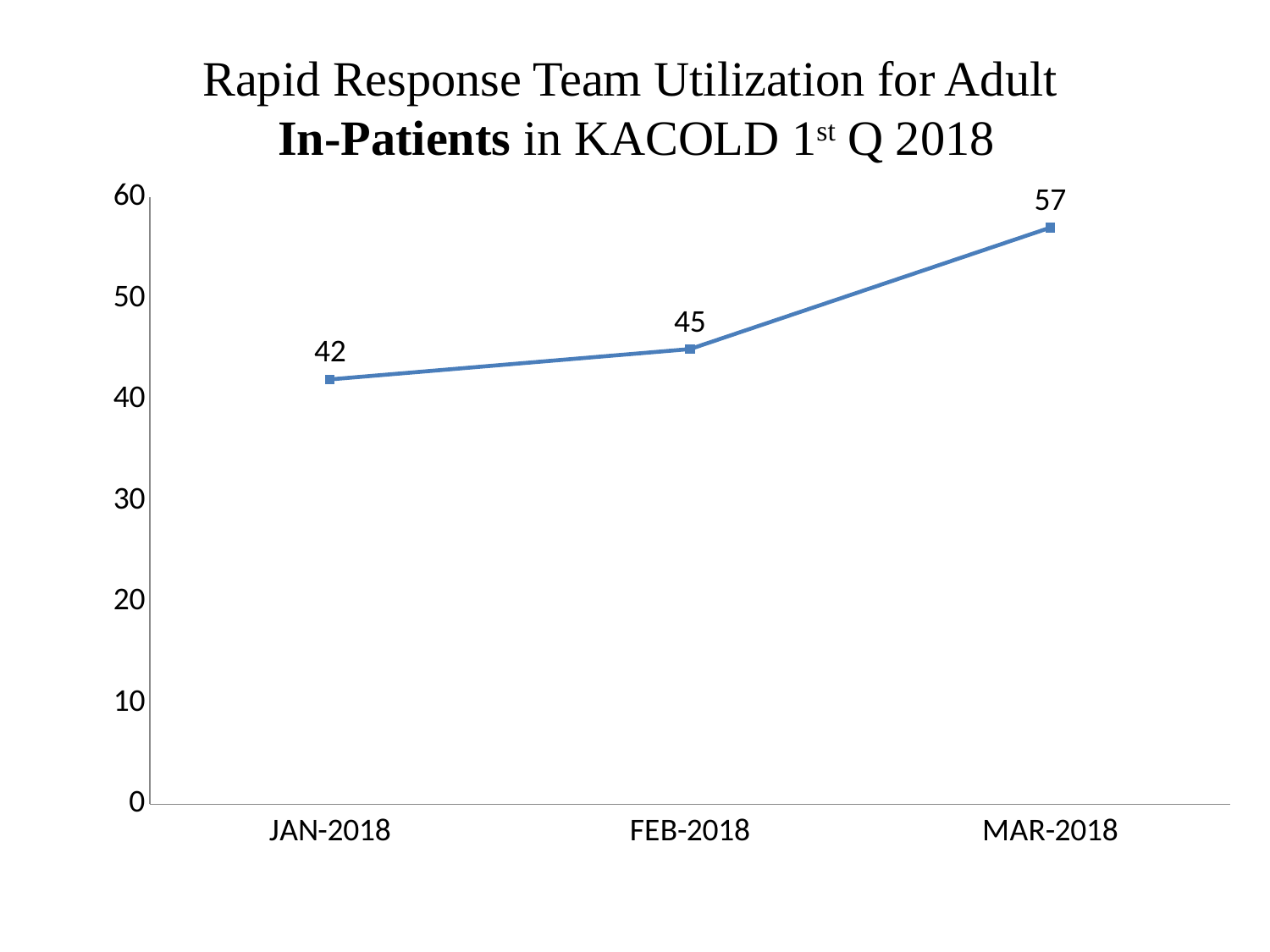
Is the value for MAR-2018 greater or less than 50? greater What is the difference between the values for MAR-2018 and JAN-2018? 15 What is the value for FEB-2018? 45 Do the values rise or fall from JAN-2018 to MAR-2018? rise Which is larger, the value for FEB-2018 or the value for MAR-2018? MAR-2018 What is the value for JAN-2018? 42 Which month has the highest value? MAR-2018 What is the value for MAR-2018? 57 How many months are plotted on the chart? 3 Which month has the lowest value? JAN-2018 What kind of chart is shown on the slide? line chart What is the difference between the values for FEB-2018 and JAN-2018? 3